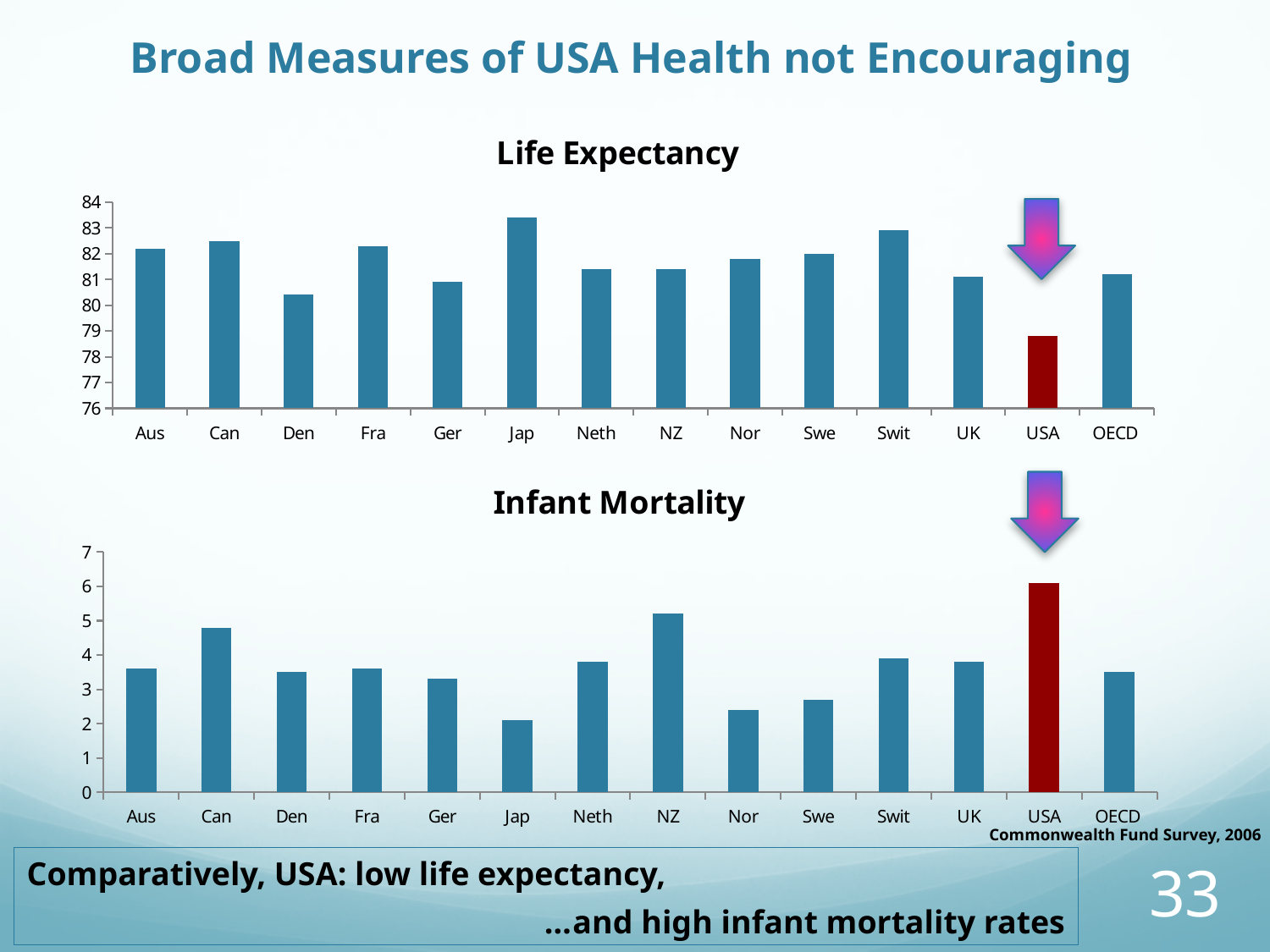
How many categories are shown in the Life Expectancy chart? 14 In the Life Expectancy chart, which category has the lowest value? USA In the Infant Mortality chart, which category has the highest value? USA In the Infant Mortality chart, is the value for Jap greater or less than 3? less In the Infant Mortality chart, which bar is coloured red instead of blue? USA What kind of chart is the Infant Mortality chart? bar chart In the Life Expectancy chart, which category has the highest value? Jap In the Life Expectancy chart, which is larger, the value for Can or the value for Den? Can In the Life Expectancy chart, is the value for Jap greater or less than 83? greater In the Infant Mortality chart, which is larger, the value for NZ or the value for Nor? NZ In the Life Expectancy chart, is the value for USA greater or less than 80? less